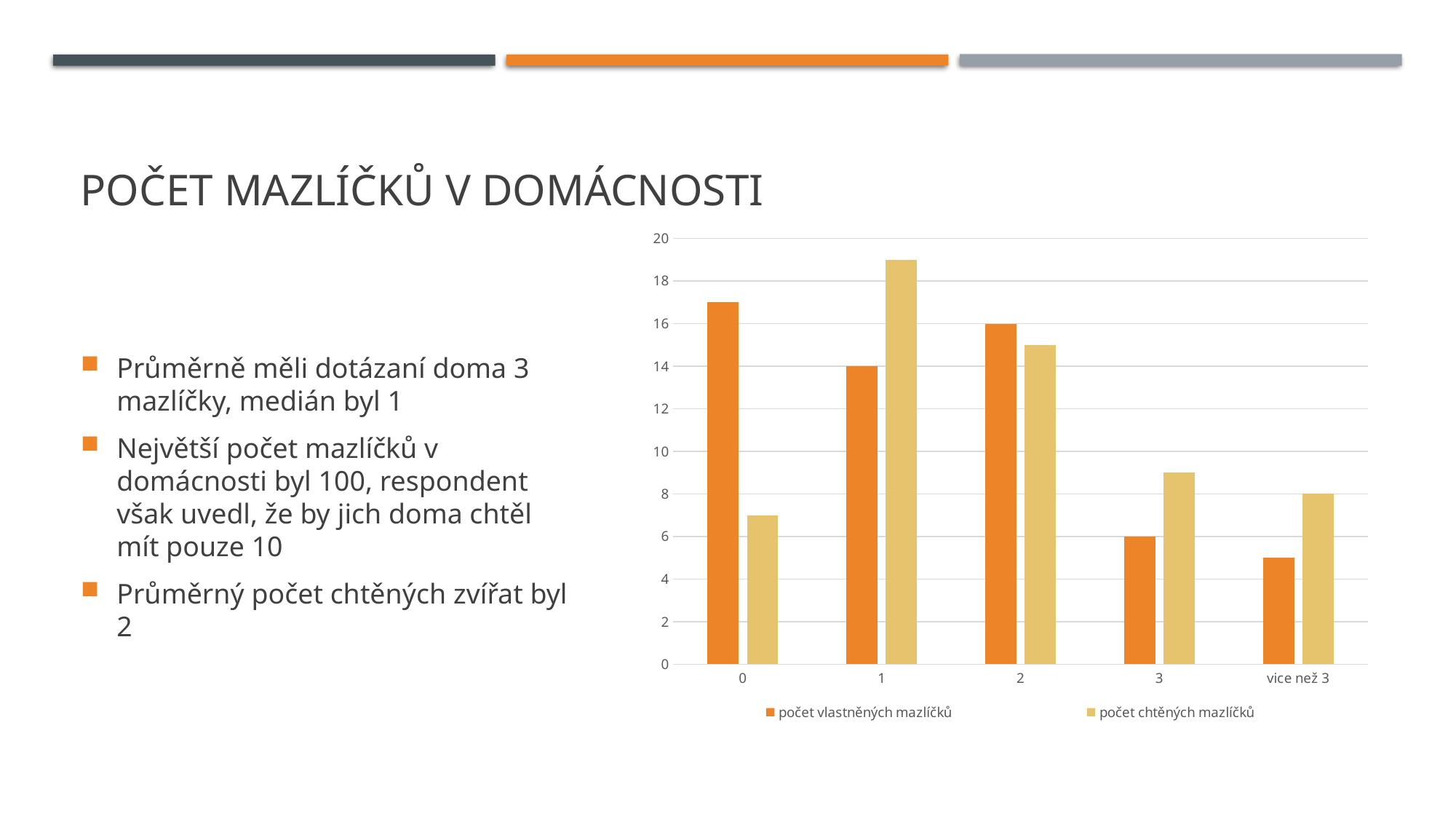
What is the value of 'počet vlastněných mazlíčků' for category 1? 14 What is the difference between 'počet vlastněných mazlíčků' for category 2 and for category 3? 10 How many categories are shown on the x axis? 5 Is the value of 'počet chtěných mazlíčků' for category 0 greater or less than 8? less Which category has the highest value for 'počet chtěných mazlíčků'? 1 How many series does the legend list? 2 What is the value of 'počet vlastněných mazlíčků' for category 2? 16 What kind of chart is shown on the slide? bar chart What is the value of 'počet chtěných mazlíčků' for 'vice než 3'? 8 What is the value of 'počet vlastněných mazlíčků' for category 3? 6 Is the value of 'počet chtěných mazlíčků' for category 1 greater or less than 18? greater For category 0, which series has the larger value: 'počet vlastněných mazlíčků' or 'počet chtěných mazlíčků'? počet vlastněných mazlíčků